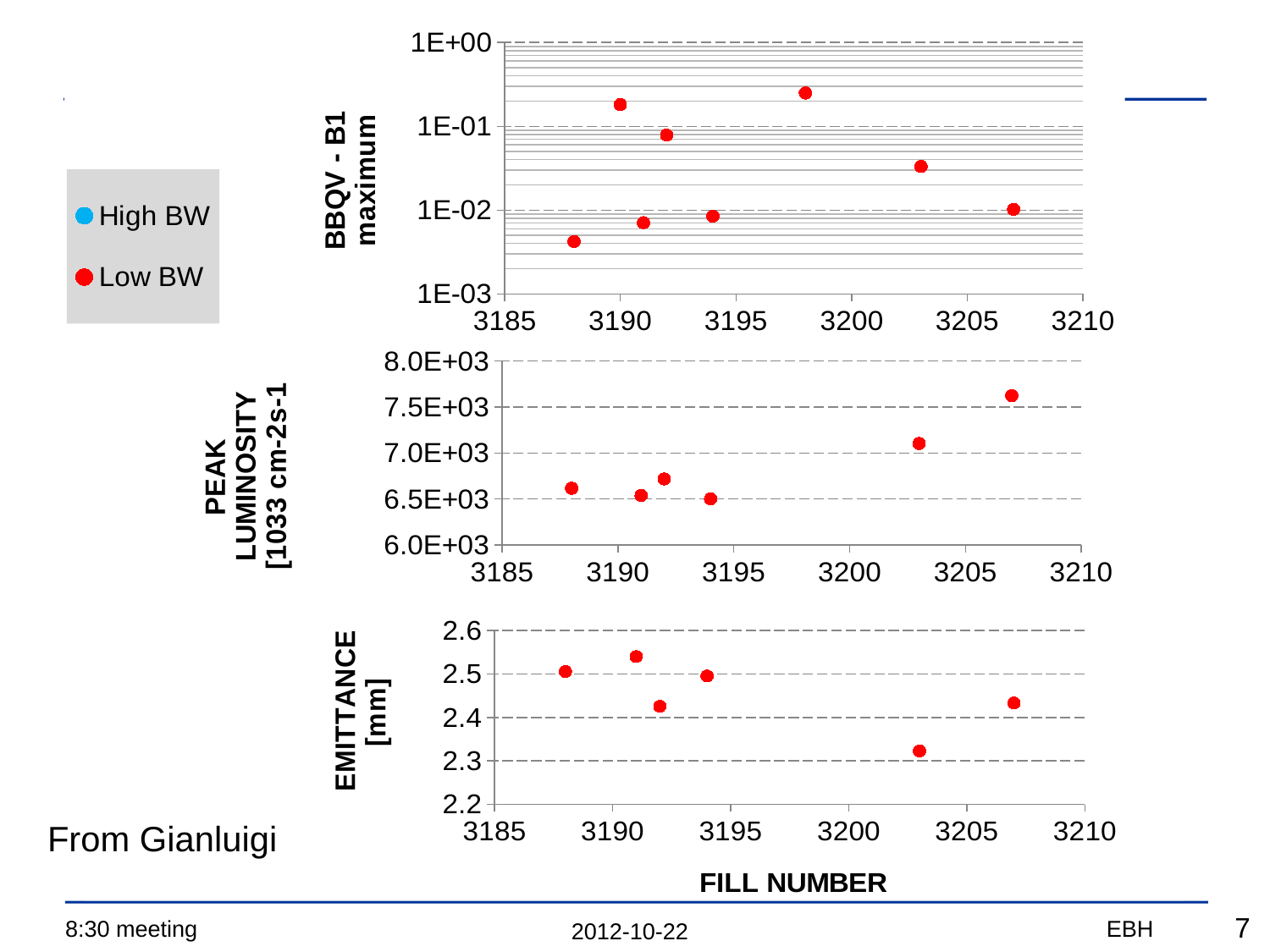
In the bottom chart (EMITTANCE), which has the larger value: fill 3191 or fill 3192? 3191 In the middle chart (PEAK LUMINOSITY), at which fill number is the value highest? 3207 How many data points are plotted in the middle chart (PEAK LUMINOSITY)? 6 How many series does the legend list? 2 In the top chart (BBQV - B1 maximum), at which fill number is the value lowest? 3188 In the top chart (BBQV - B1 maximum), is the value at fill 3203 greater or less than 1E-02? greater What is the title of the shared x axis of the charts? FILL NUMBER In the top chart (BBQV - B1 maximum), at which fill number is the value highest? 3198 In the bottom chart (EMITTANCE), at which fill number is the value lowest? 3203 In the middle chart (PEAK LUMINOSITY), is the value at fill 3203 greater or less than 7.0E+03? greater What kind of chart is the top chart (BBQV - B1 maximum)? scatter chart In the top chart (BBQV - B1 maximum), is the value at fill 3192 greater or less than 1E-01? less